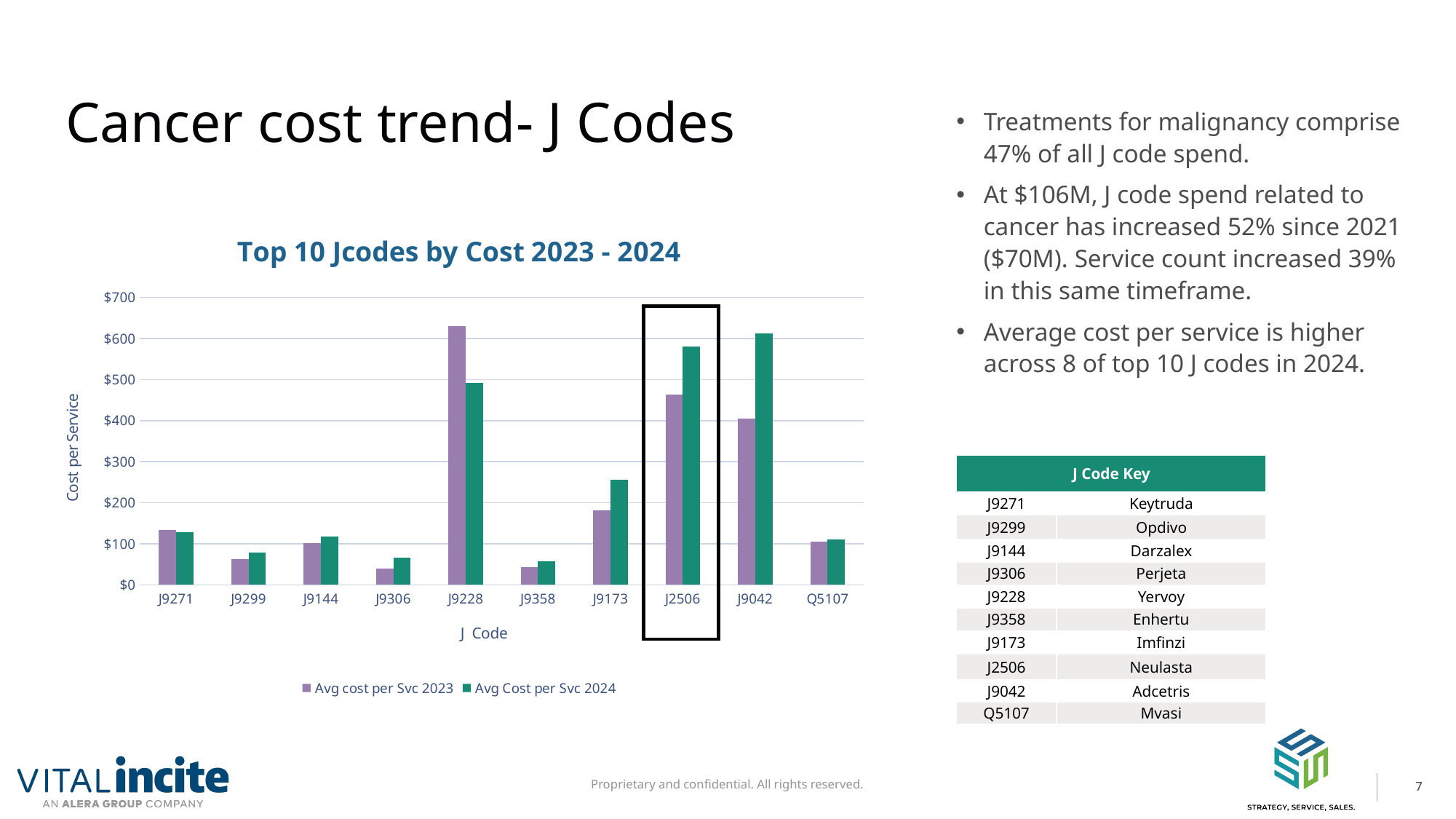
For J9228, which is larger: the average cost per service in 2023 or in 2024? 2023 Is the 2024 average cost per service for J2506 greater or less than $500? greater How many J codes are shown on the x axis of the chart? 10 What kind of chart is shown on the slide? Bar chart Which J code has the highest average cost per service in 2024? J9042 For J9042, which is larger: the average cost per service in 2023 or in 2024? 2024 Is the 2023 average cost per service for J9228 greater or less than $600? greater Which J code has the highest average cost per service in 2023? J9228 Is the 2023 average cost per service for J9173 greater or less than $200? less What is the title of the chart? Top 10 Jcodes by Cost 2023 - 2024 How many series does the chart legend list? 2